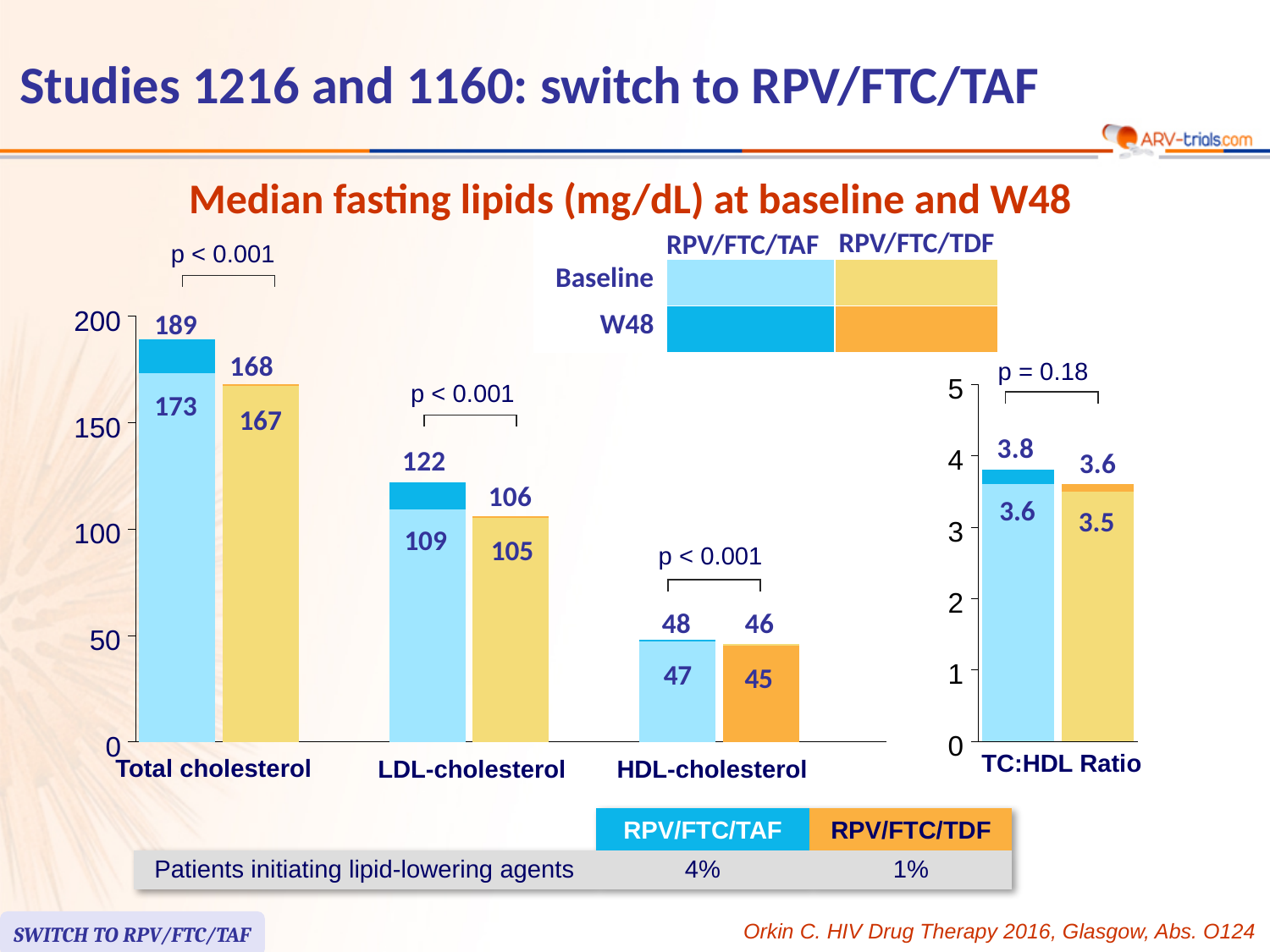
In the left chart, what is the baseline median total cholesterol for RPV/FTC/TDF? 167 In the left chart, what is the difference between the W48 LDL-cholesterol values for RPV/FTC/TAF and RPV/FTC/TDF? 16 In the left chart, what is the W48 median LDL-cholesterol for RPV/FTC/TAF? 122 What p-value is shown above the TC:HDL Ratio bars? p = 0.18 In the left chart, what is the difference between the W48 and baseline median total cholesterol for RPV/FTC/TAF? 16 In the left chart, what is the W48 median total cholesterol for RPV/FTC/TAF? 189 How many lipid categories are shown on the x axis of the left chart? 3 In the TC:HDL Ratio chart, what is the baseline value for RPV/FTC/TDF? 3.5 In the left chart, what is the baseline median HDL-cholesterol for RPV/FTC/TDF? 45 In the left chart, is the W48 total cholesterol for RPV/FTC/TAF greater or less than 150? greater In the left chart, which lipid category has the lowest values? HDL-cholesterol In the TC:HDL Ratio chart, what is the W48 value for RPV/FTC/TAF? 3.8